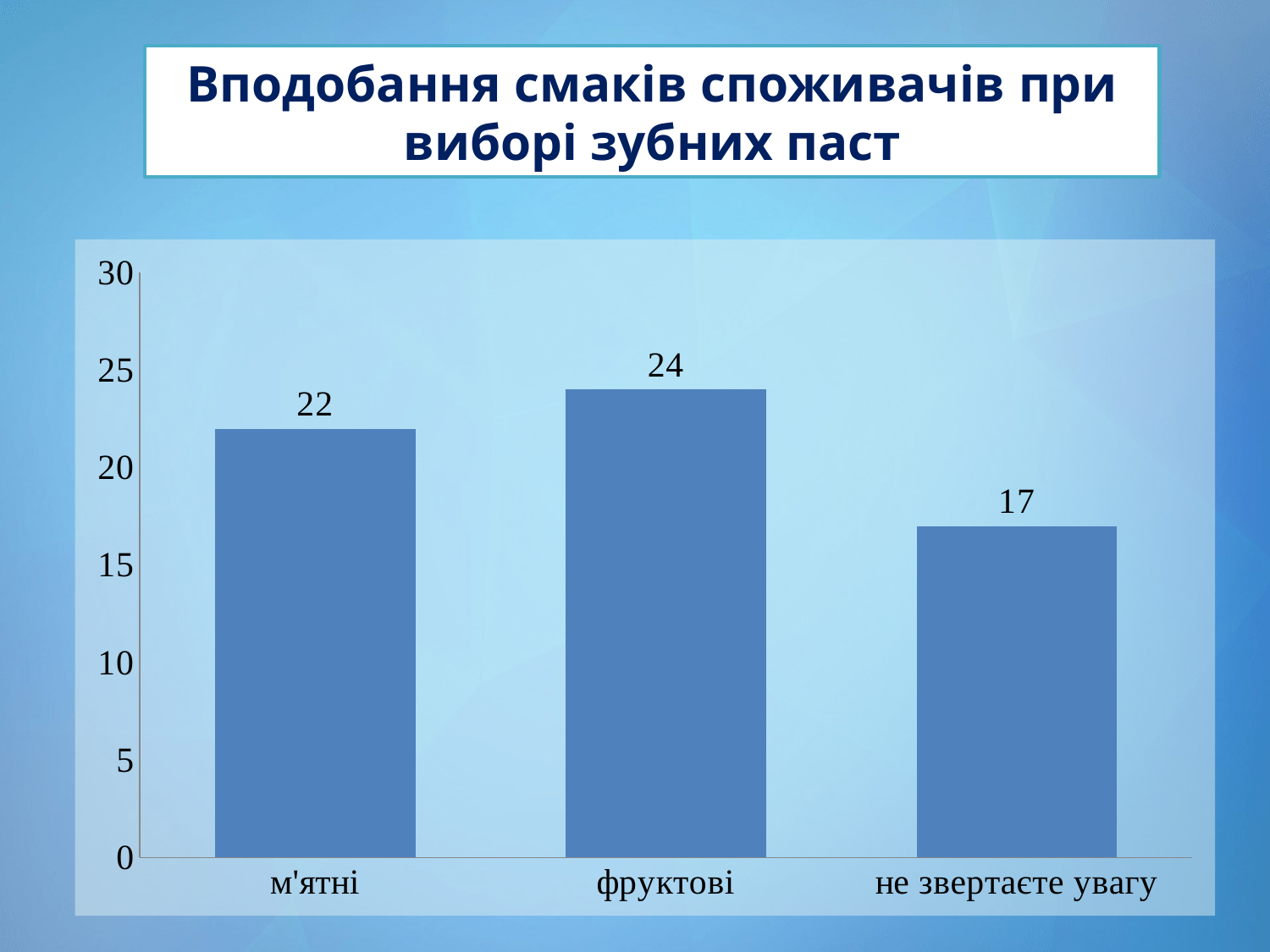
How many categories are shown on the chart? 3 What is the value for фруктові? 24 What kind of chart is shown on the slide? bar chart Which category has the lowest value? не звертаєте увагу What is the value for м'ятні? 22 What is the difference between the values for м'ятні and не звертаєте увагу? 5 Which category has the highest value? фруктові Which is larger, the value for м'ятні or the value for не звертаєте увагу? м'ятні What is the title of the slide? Вподобання смаків споживачів при виборі зубних паст What is the value for не звертаєте увагу? 17 Is the value for фруктові greater or less than 20? greater What is the difference between the values for фруктові and м'ятні? 2